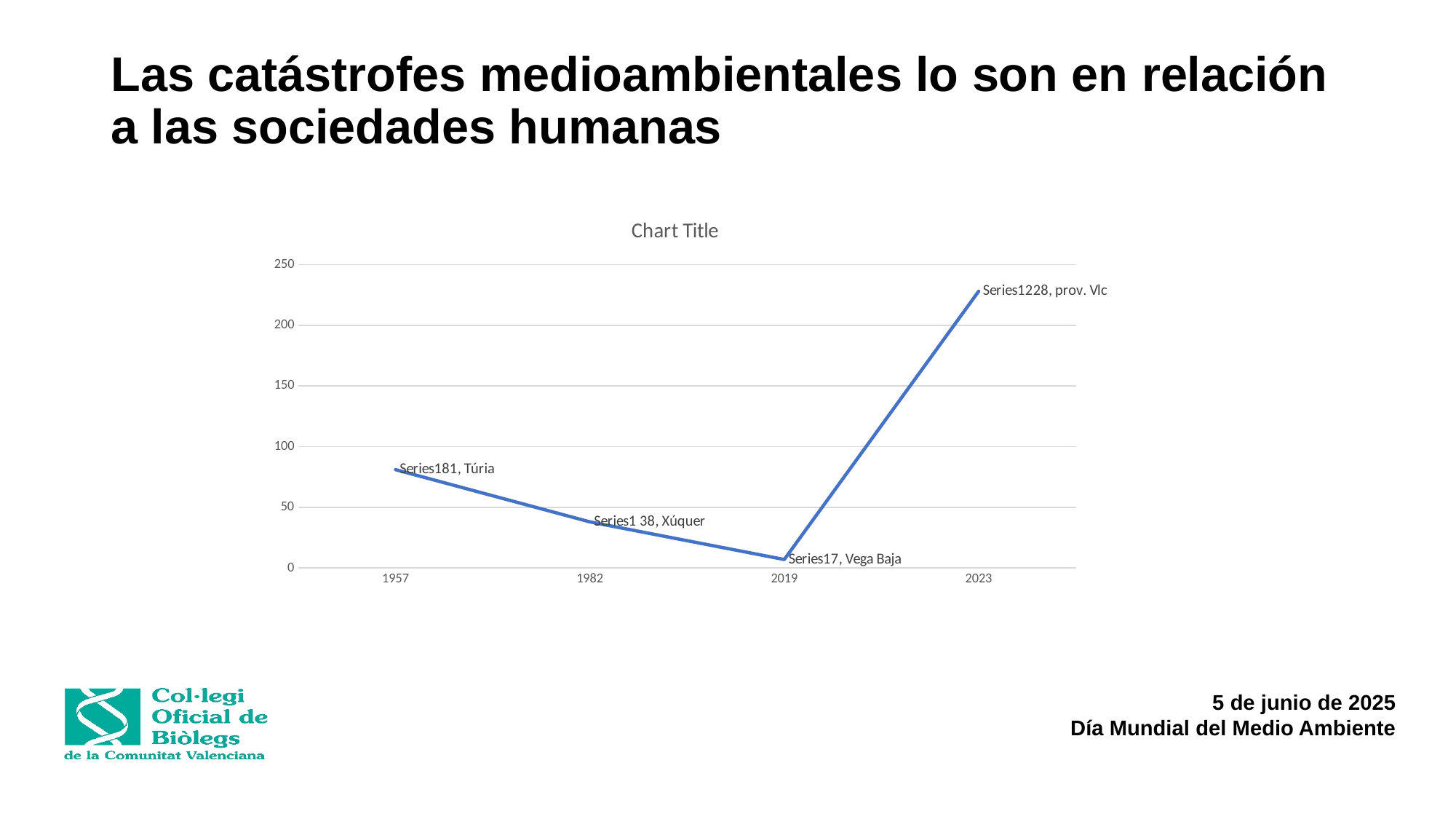
What value is labelled for the 1982 point (Xúquer)? 38 What kind of chart is shown on the slide? line chart How many data points are plotted on the line chart? 4 How do the values change from 1957 to 2019 along the x axis? they fall Which is larger, the value for 1957 or the value for 1982? 1957 Is the value for 1957 greater or less than 50? greater Which year has the highest value on the chart? 2023 Is the value for 2023 greater or less than 200? greater Which year has the lowest value on the chart? 2019 What value is labelled for the 2023 point (prov. Vlc)? 228 What is the title shown above the chart? Chart Title Is the value for 2019 greater or less than 50? less